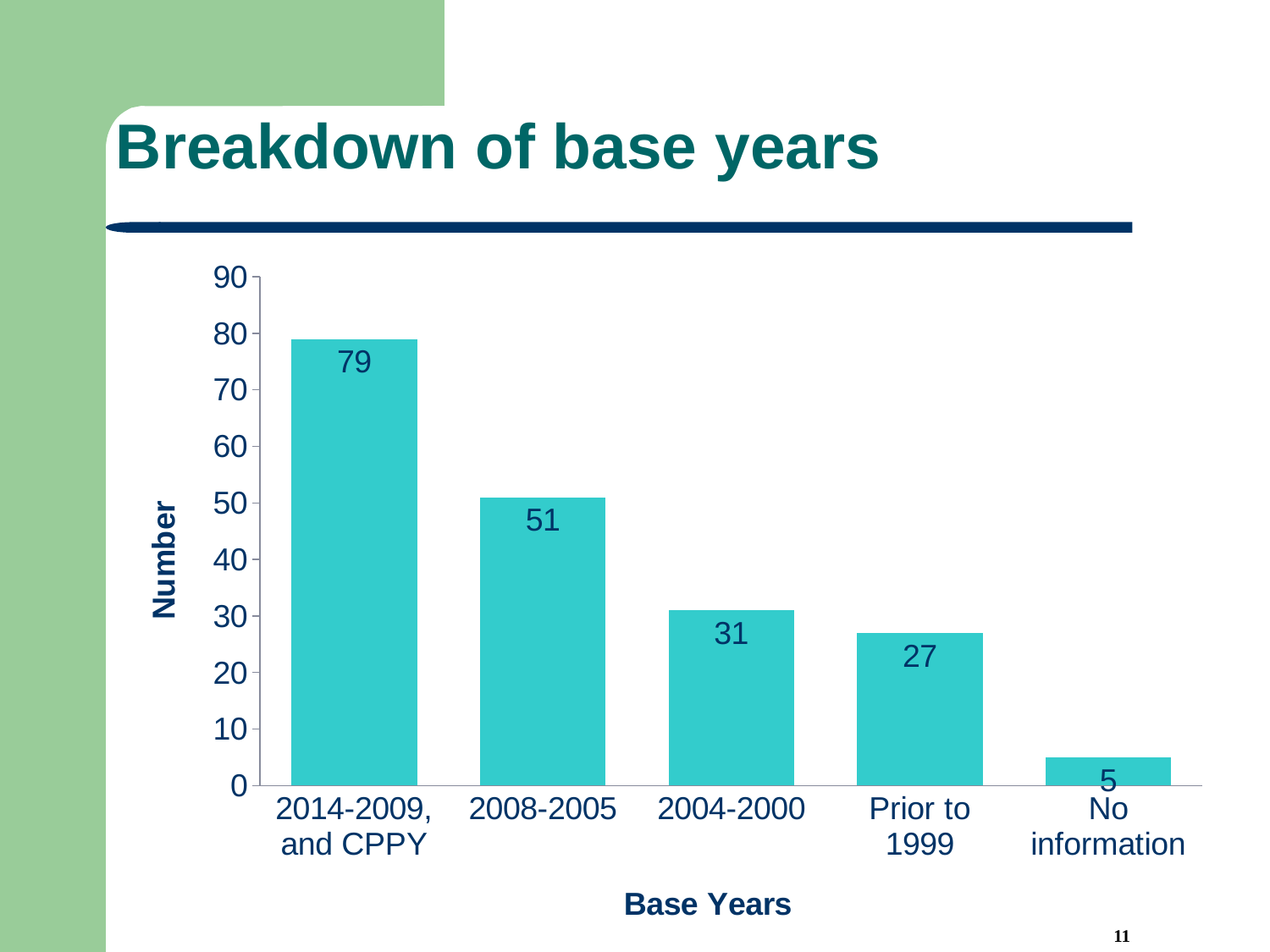
What is the value for the Prior to 1999 category? 27 How many categories are shown on the x axis? 5 Which category has the lowest number? No information What is the label of the y axis? Number Do the values rise or fall from left to right along the x axis? Fall What is the difference between the values for 2008-2005 and 2004-2000? 20 What is the value for the 2008-2005 category? 51 What is the value for the No information category? 5 Which base years category has the highest number? 2014-2009, and CPPY What kind of chart is shown on the slide? Bar chart Which is larger, the value for 2004-2000 or the value for Prior to 1999? 2004-2000 What is the value for the 2014-2009, and CPPY base years category? 79